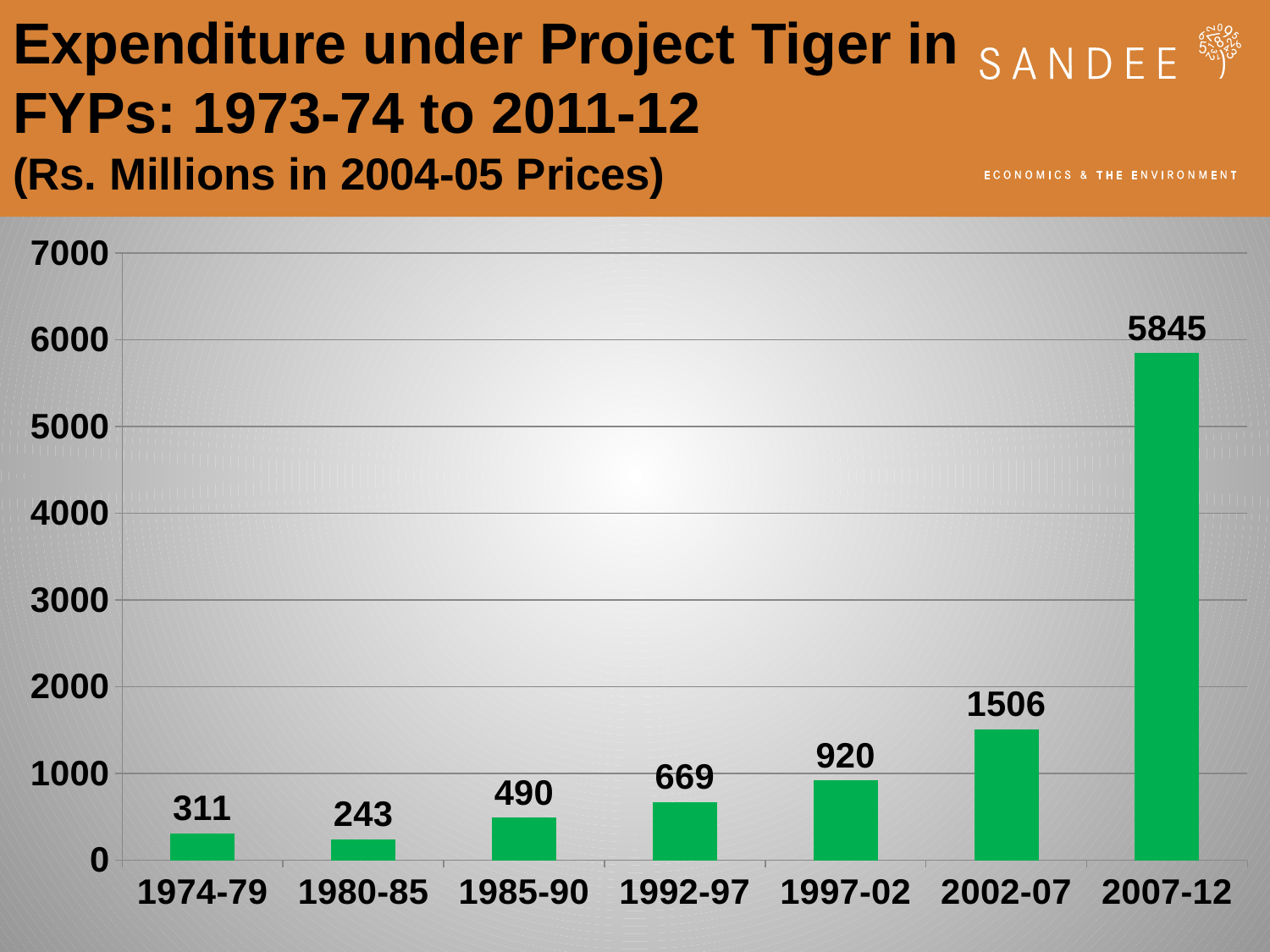
What is the expenditure under Project Tiger for the 1985-90 plan period? 490 How many plan periods are shown on the chart? 7 Which plan period has the lowest expenditure under Project Tiger? 1980-85 Which plan period had higher expenditure, 1974-79 or 1980-85? 1974-79 What is the difference in expenditure between the 2007-12 and 2002-07 plan periods? 4339 What is the expenditure under Project Tiger for the 1974-79 plan period? 311 What colour are the bars in the chart? Green What is the expenditure under Project Tiger for the 2002-07 plan period? 1506 Which plan period has the highest expenditure under Project Tiger? 2007-12 What is the difference in expenditure between the 1997-02 and 1992-97 plan periods? 251 Is the expenditure for the 2002-07 plan period greater or less than 2000? less What type of chart is used to show expenditure under Project Tiger? Bar chart